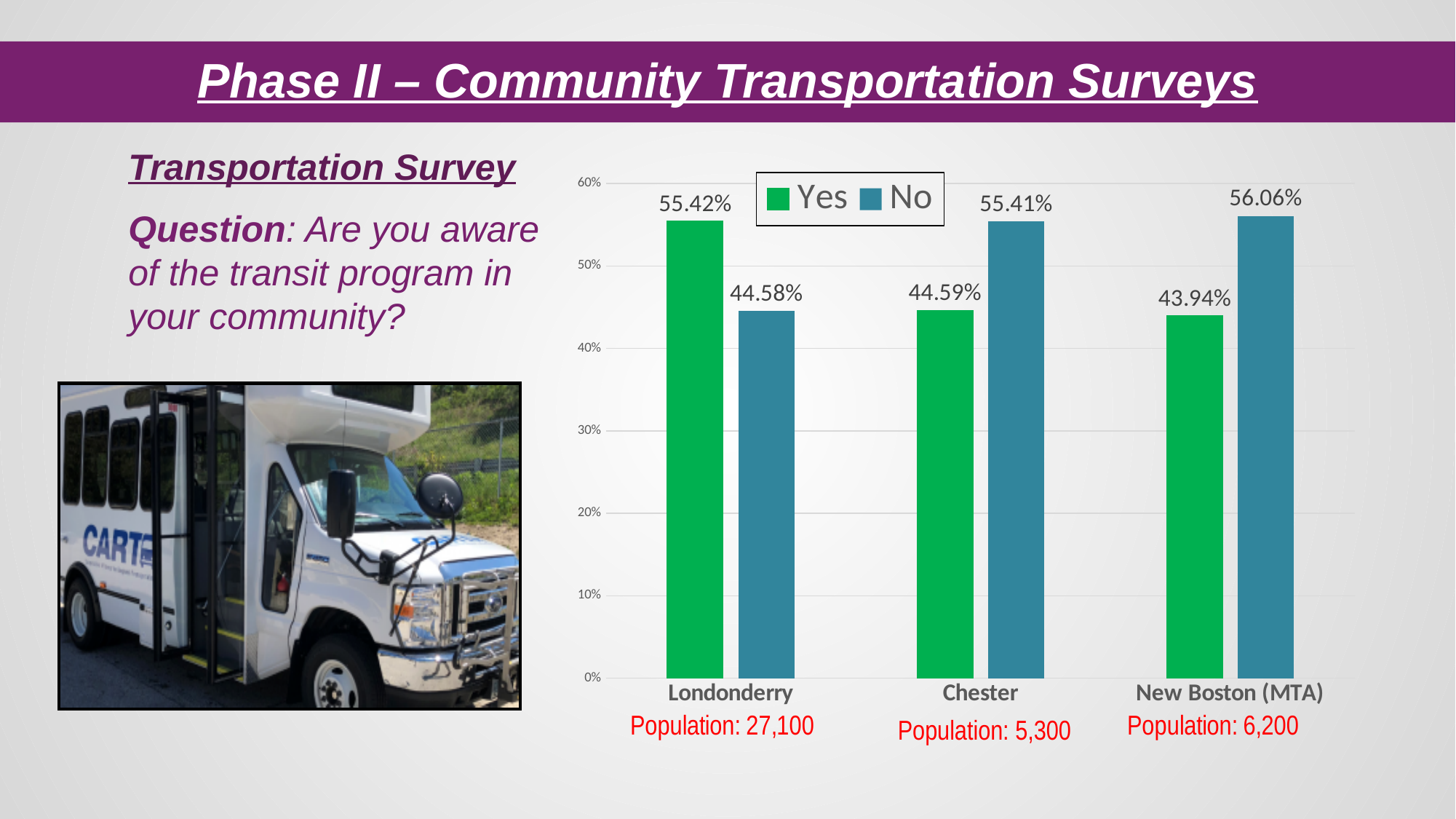
What is the difference between the 'Yes' and 'No' values for Londonderry? 10.84% What is the 'No' value for Chester? 55.41% What is the 'Yes' value for Londonderry? 55.42% Is the 'No' value for New Boston (MTA) greater or less than 50%? greater How many series does the legend list? 2 Which community has the highest 'No' value? New Boston (MTA) Which community has the lowest 'Yes' value? New Boston (MTA) What is the 'Yes' value for New Boston (MTA)? 43.94% How many communities are shown on the x axis? 3 What is the 'No' value for Londonderry? 44.58% For Chester, which is larger, the 'Yes' value or the 'No' value? No What kind of chart is shown on the slide? Bar chart